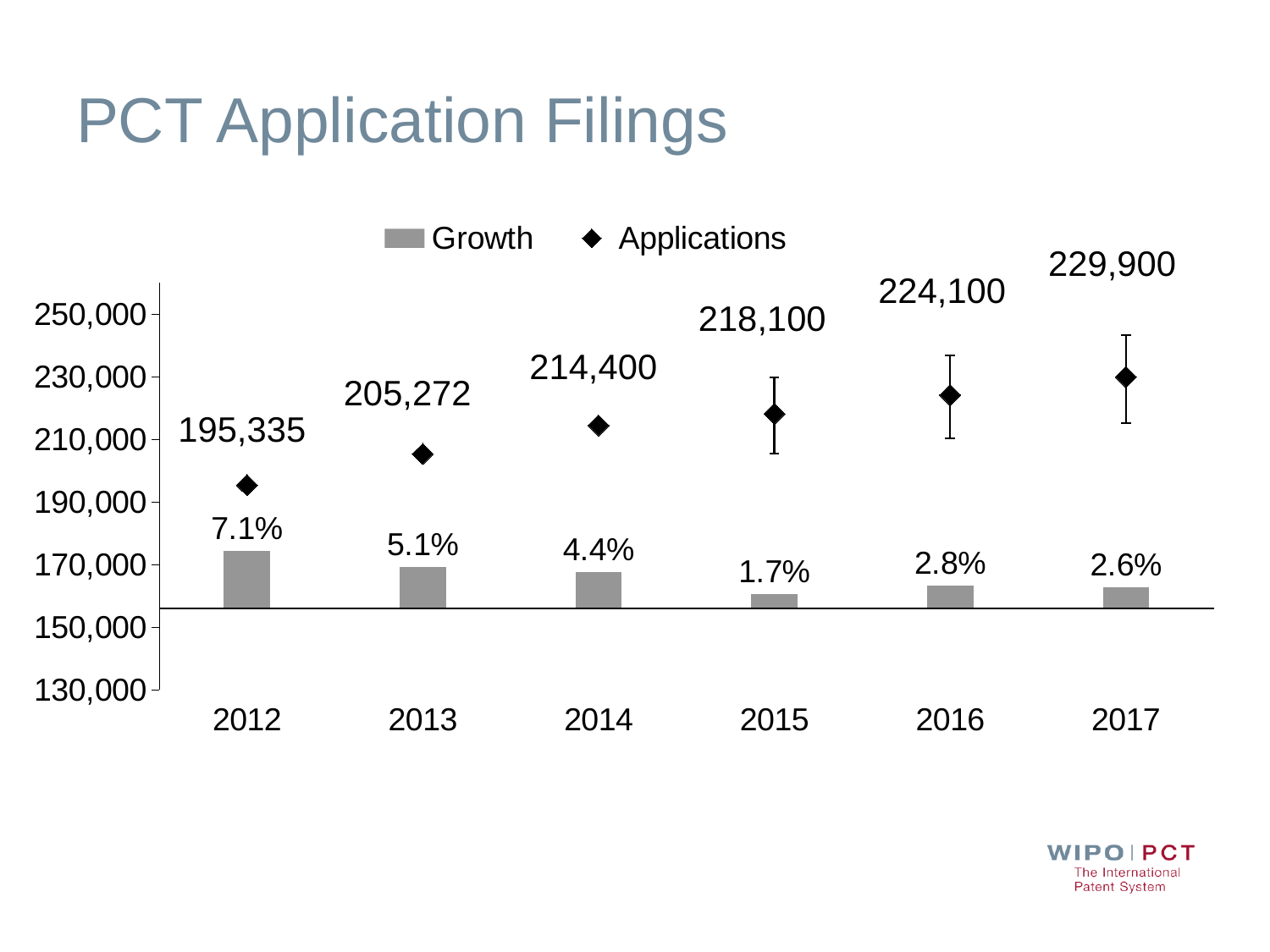
Do the Applications values rise or fall from 2012 to 2017? rise What is the difference in Applications between 2017 and 2012? 34,565 Which year has the highest number of Applications? 2017 What is the number of Applications for 2012? 195,335 How many years are shown on the x axis? 6 How many series does the legend list? 2 What is the Growth value for 2015? 1.7% What is the difference in Applications between 2016 and 2015? 6,000 Which year has the larger Growth value, 2016 or 2017? 2016 What is the number of Applications for 2014? 214,400 Which year has the highest Growth value? 2012 Which year has the lowest Growth value? 2015